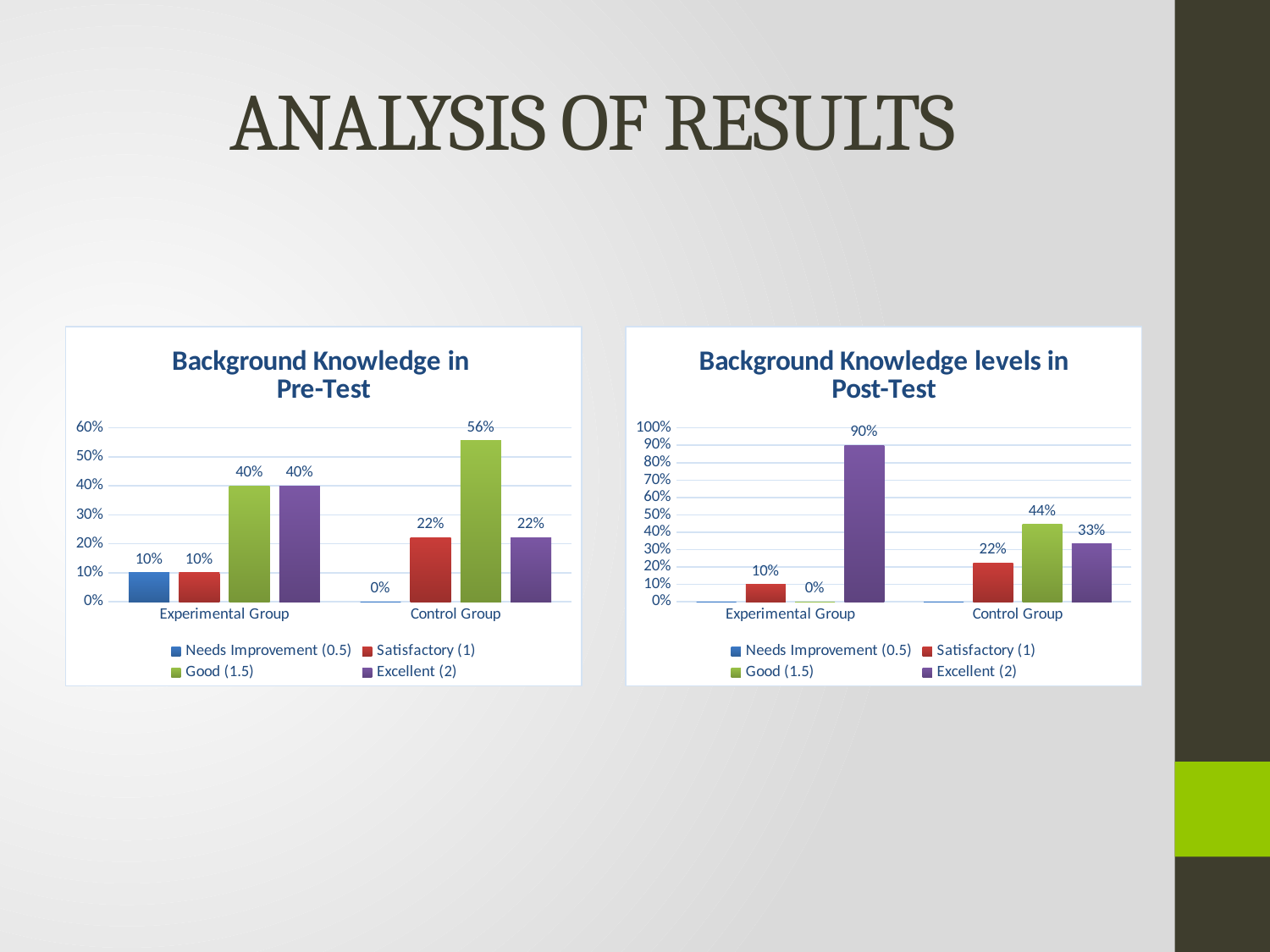
In the 'Background Knowledge levels in Post-Test' chart, what is the value for Good (1.5) in the Control Group? 44% In the 'Background Knowledge levels in Post-Test' chart, what colour represents Excellent (2)? Purple In the 'Background Knowledge levels in Post-Test' chart, what is the value for Excellent (2) in the Experimental Group? 90% In the 'Background Knowledge in Pre-Test' chart, what is the value for Needs Improvement (0.5) in the Control Group? 0% In the 'Background Knowledge levels in Post-Test' chart, which series has the highest value in the Control Group? Good (1.5) In the 'Background Knowledge in Pre-Test' chart, what is the value for Excellent (2) in the Experimental Group? 40% What kind of chart is 'Background Knowledge levels in Post-Test'? Bar chart How many series does the legend of the 'Background Knowledge in Pre-Test' chart list? 4 In the 'Background Knowledge levels in Post-Test' chart, what is the difference between Excellent (2) in the Experimental Group and Excellent (2) in the Control Group? 57% In the 'Background Knowledge in Pre-Test' chart, what is the value for Good (1.5) in the Control Group? 56% In the 'Background Knowledge levels in Post-Test' chart, which is larger: Satisfactory (1) in the Control Group or Satisfactory (1) in the Experimental Group? Control Group In the 'Background Knowledge in Pre-Test' chart, what is the difference between Good (1.5) in the Control Group and Good (1.5) in the Experimental Group? 16%